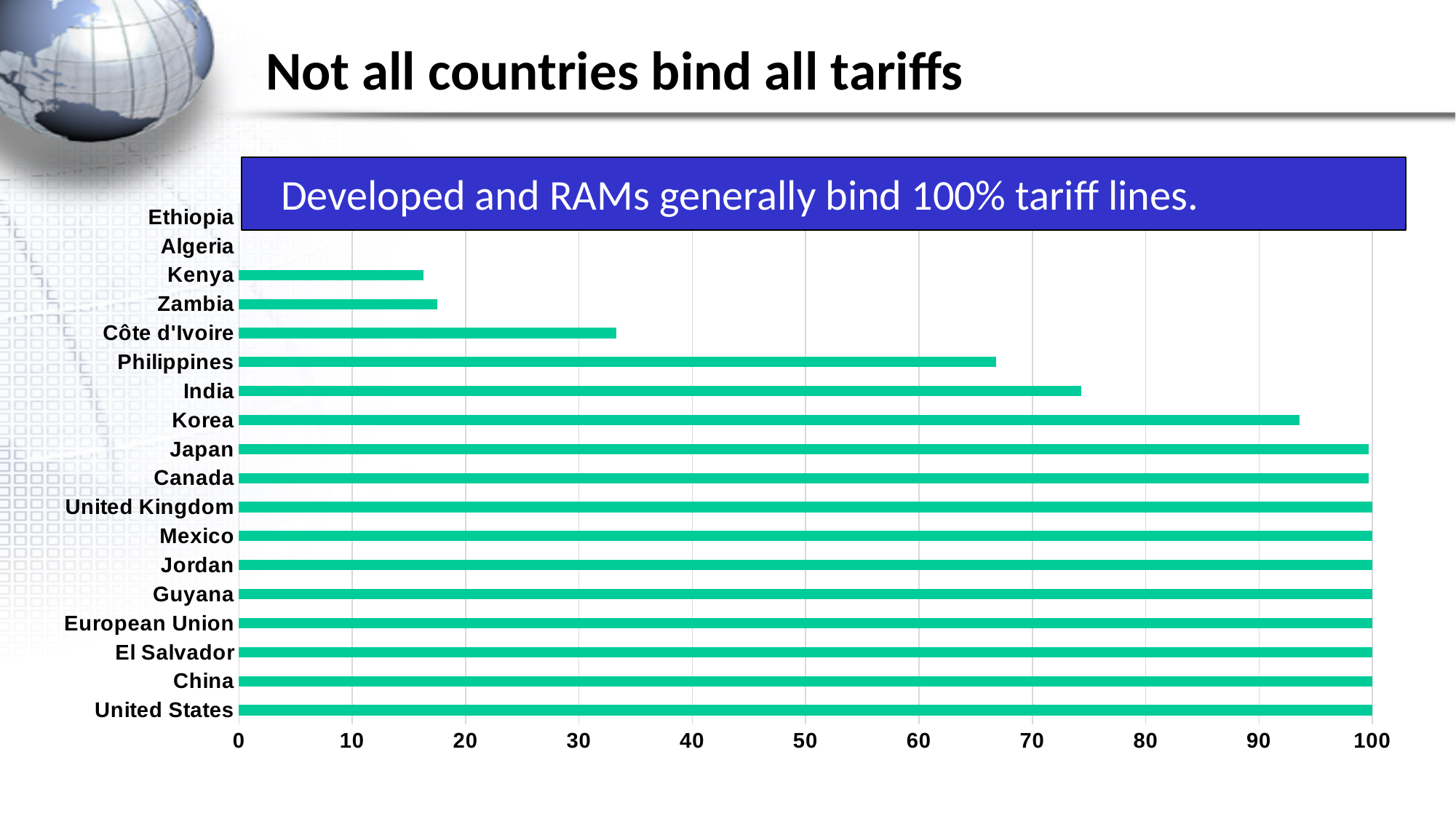
Which has the larger value, Zambia or Côte d'Ivoire? Côte d'Ivoire Is the value for India greater or less than 80? less How many countries are listed on the chart? 18 Is the value for Kenya greater or less than 20? less What is the value for United States? 100 What does the blue text box on the chart say? Developed and RAMs generally bind 100% tariff lines. What kind of chart is shown on the slide? bar chart Is the value for Korea greater or less than 90? greater What is the title of the slide? Not all countries bind all tariffs Which has the larger value, Philippines or India? India